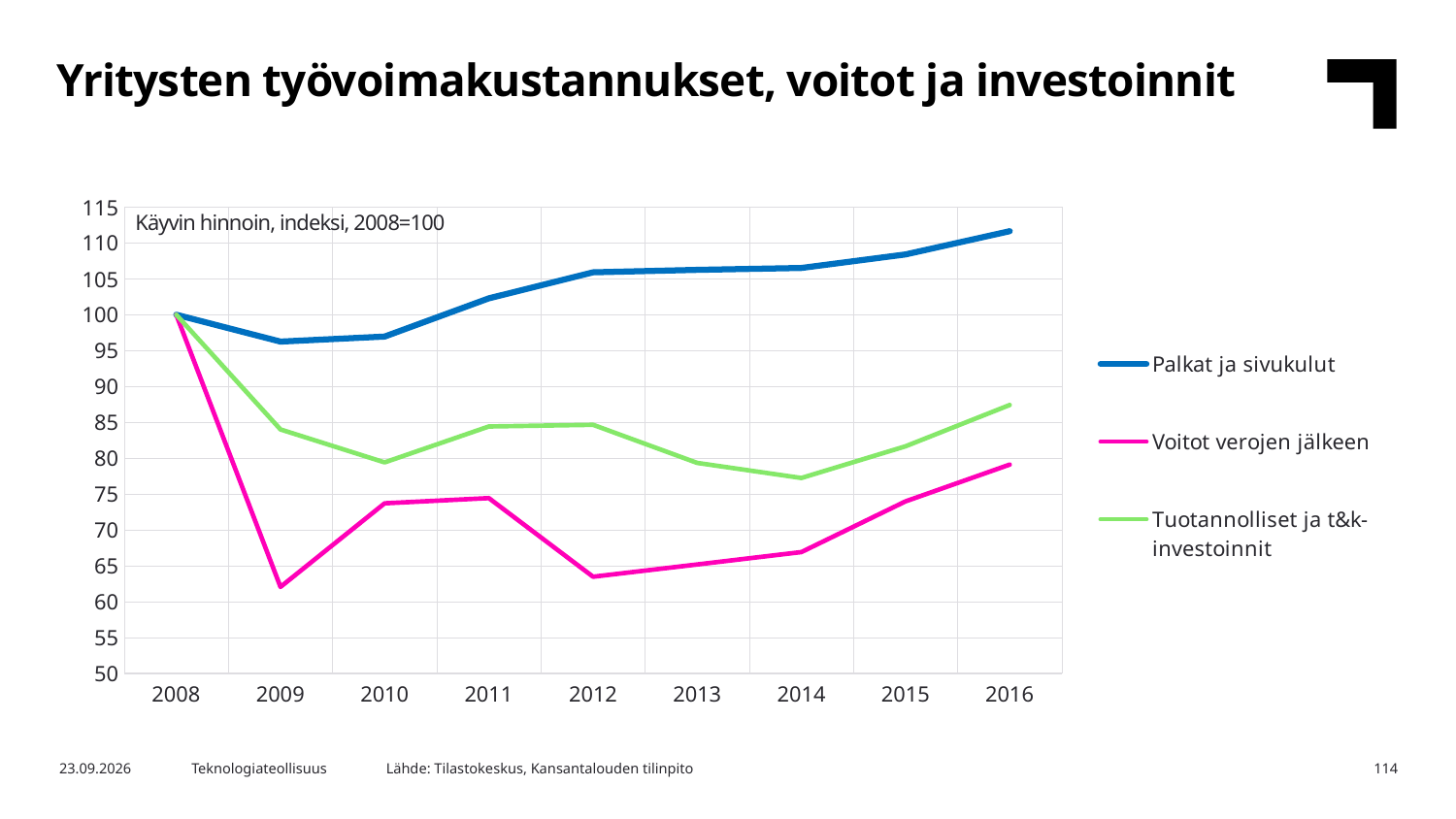
Is the value for Palkat ja sivukulut in 2016 greater or less than 110? greater Does the Voitot verojen jälkeen line rise or fall from 2012 to 2016? Rise What kind of chart is shown on the slide? Line chart In 2016, which series has the higher value: Palkat ja sivukulut or Voitot verojen jälkeen? Palkat ja sivukulut How many years are shown on the x axis? 9 What is the index value of all three series in 2008? 100 In which year does Palkat ja sivukulut reach its highest value? 2016 Is the value for Tuotannolliset ja t&k-investoinnit in 2014 greater or less than 80? less How many series does the legend list? 3 What colour is the line for Voitot verojen jälkeen? Pink Is the value for Voitot verojen jälkeen in 2009 greater or less than 65? less In which year does Voitot verojen jälkeen reach its lowest value? 2009